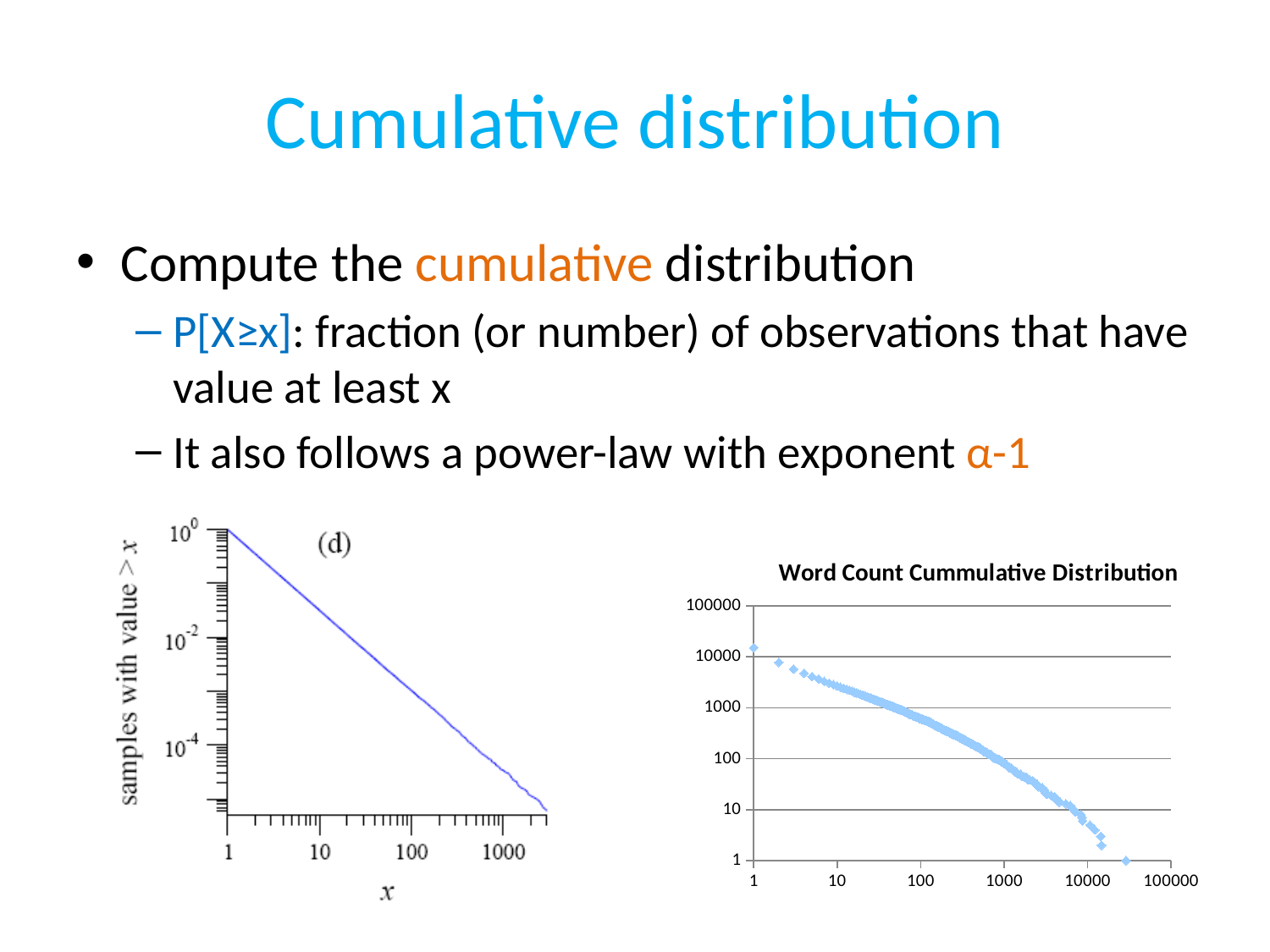
In the 'Word Count Cummulative Distribution' chart, is the value at x = 100 greater or less than 1000? less In the 'Word Count Cummulative Distribution' chart, which has the larger value: the point at x = 1 or the point at x = 1000? x = 1 In the 'Word Count Cummulative Distribution' chart, is the value at x = 100 greater or less than 100? greater What is the title of the chart on the right side of the slide? Word Count Cummulative Distribution In the 'Word Count Cummulative Distribution' chart, is the value at x = 1 greater or less than 10000? greater What kind of chart is the 'Word Count Cummulative Distribution' chart on the right? scatter chart In the 'Word Count Cummulative Distribution' chart, what is the highest tick value shown on the vertical axis? 100000 In the 'Word Count Cummulative Distribution' chart, do the values rise or fall as x increases? fall In the chart on the left labelled (d), does the line rise or fall as x increases? fall What kind of chart is the chart on the left side of the slide, labelled (d)? line chart What is the label of the vertical axis of the chart on the left labelled (d)? samples with value > x